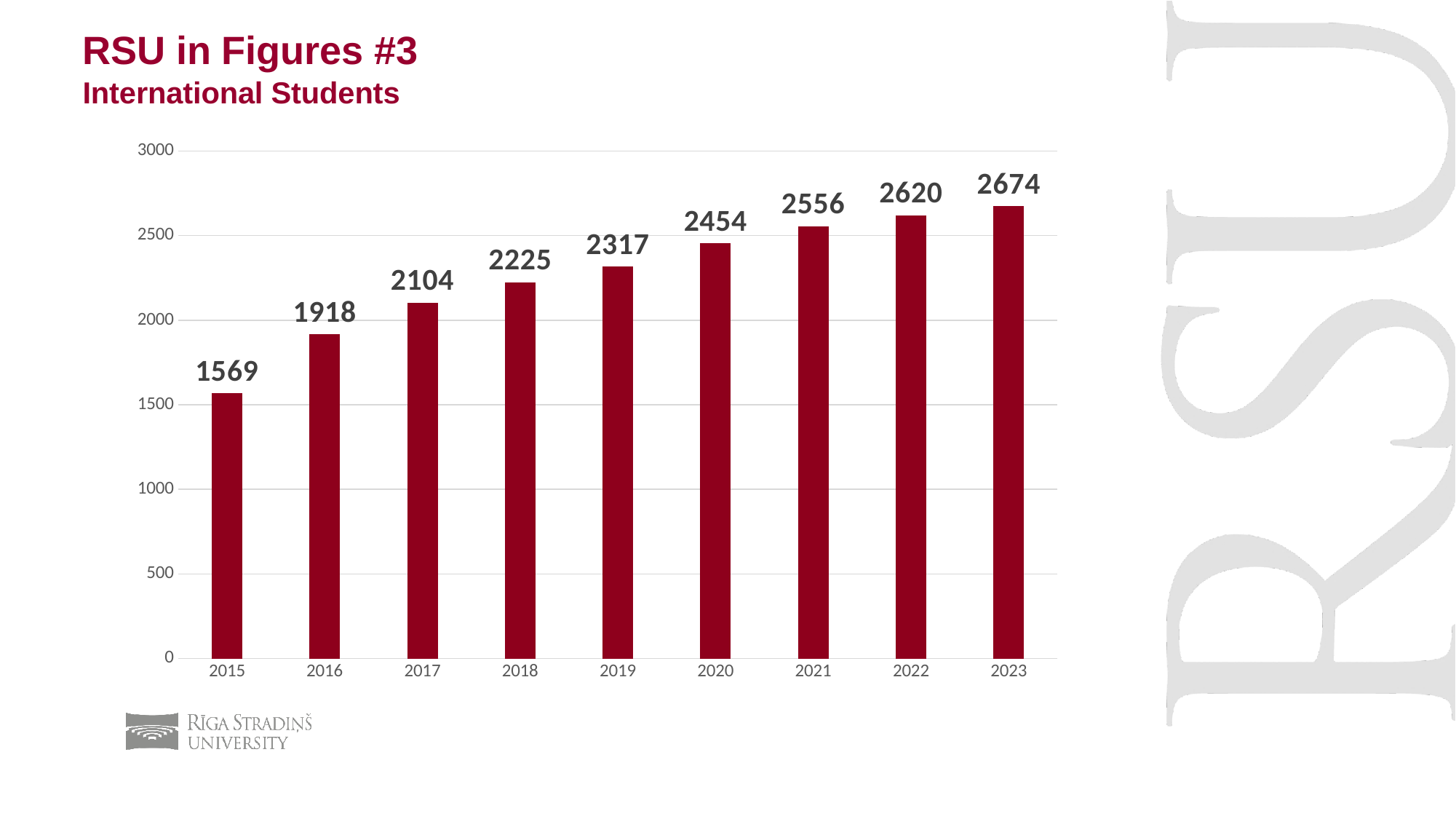
What is the difference between the values for 2023 and 2015? 1105 Which is larger, the value for 2017 or the value for 2018? 2018 How many international students were there in 2015? 1569 Which year has the lowest number of international students? 2015 What is the difference between the values for 2021 and 2020? 102 Do the values rise or fall from 2015 to 2023? rise Is the value for 2016 greater or less than 2000? less How many years are shown on the x axis? 9 What kind of chart is shown on the slide? bar chart What is the value shown for 2022? 2620 What is the value shown for 2019? 2317 Which year has the highest number of international students? 2023